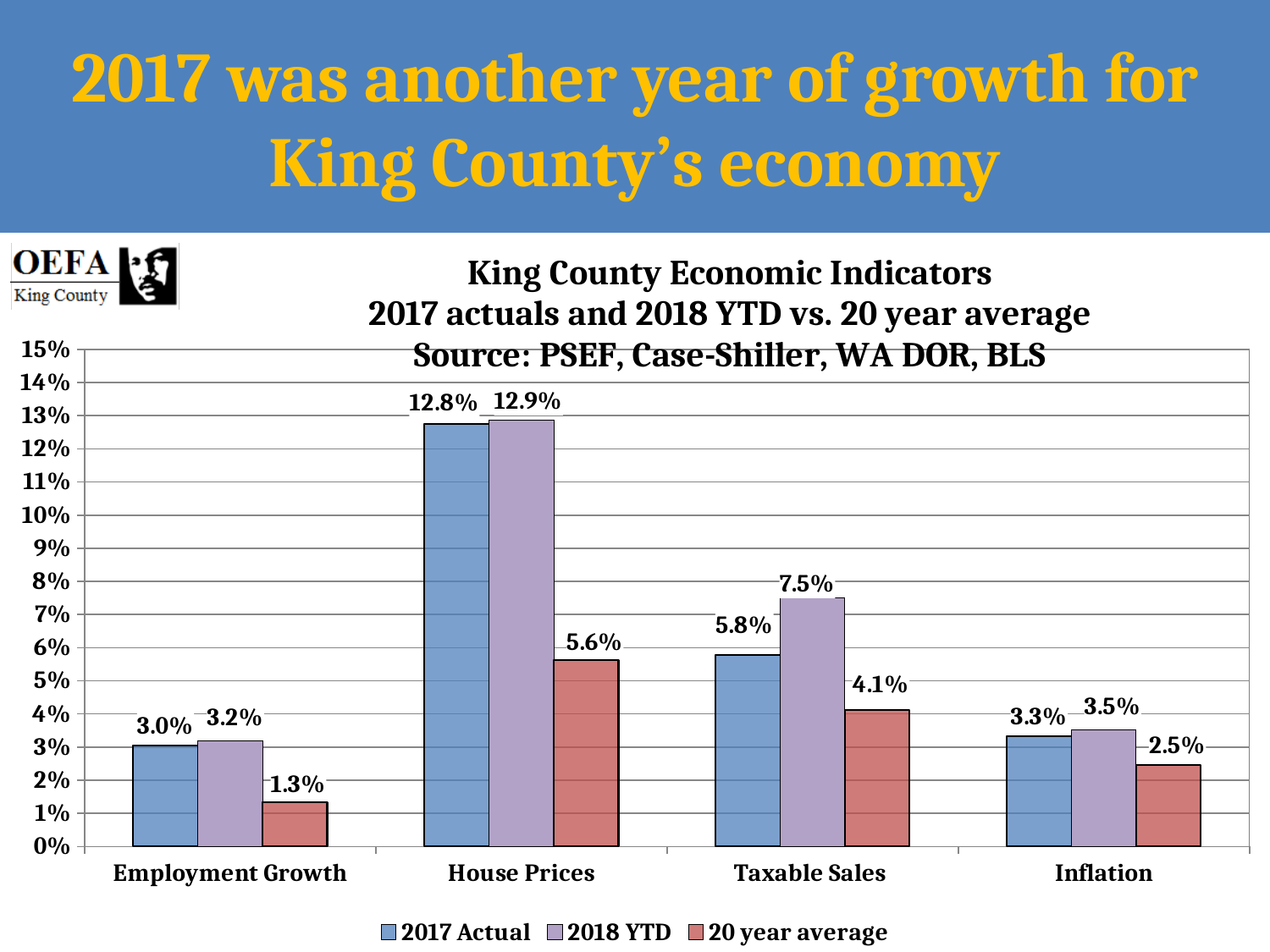
What is the 2018 YTD value for Inflation? 3.5% What is the difference between the 2018 YTD and 2017 Actual values for Taxable Sales? 1.7% How many series does the legend list? 3 What is the 2017 Actual value for House Prices? 12.8% What kind of chart is shown on the slide? Bar chart What is the difference between the 2018 YTD and 20 year average values for House Prices? 7.3% Which is larger for Employment Growth: the 2017 Actual value or the 20 year average? 2017 Actual What is the title of the chart? King County Economic Indicators 2017 actuals and 2018 YTD vs. 20 year average Source: PSEF, Case-Shiller, WA DOR, BLS How many categories are shown on the x axis? 4 Which category has the highest 2018 YTD value? House Prices What is the 20 year average value for Taxable Sales? 4.1% Which category has the lowest 20 year average value? Employment Growth